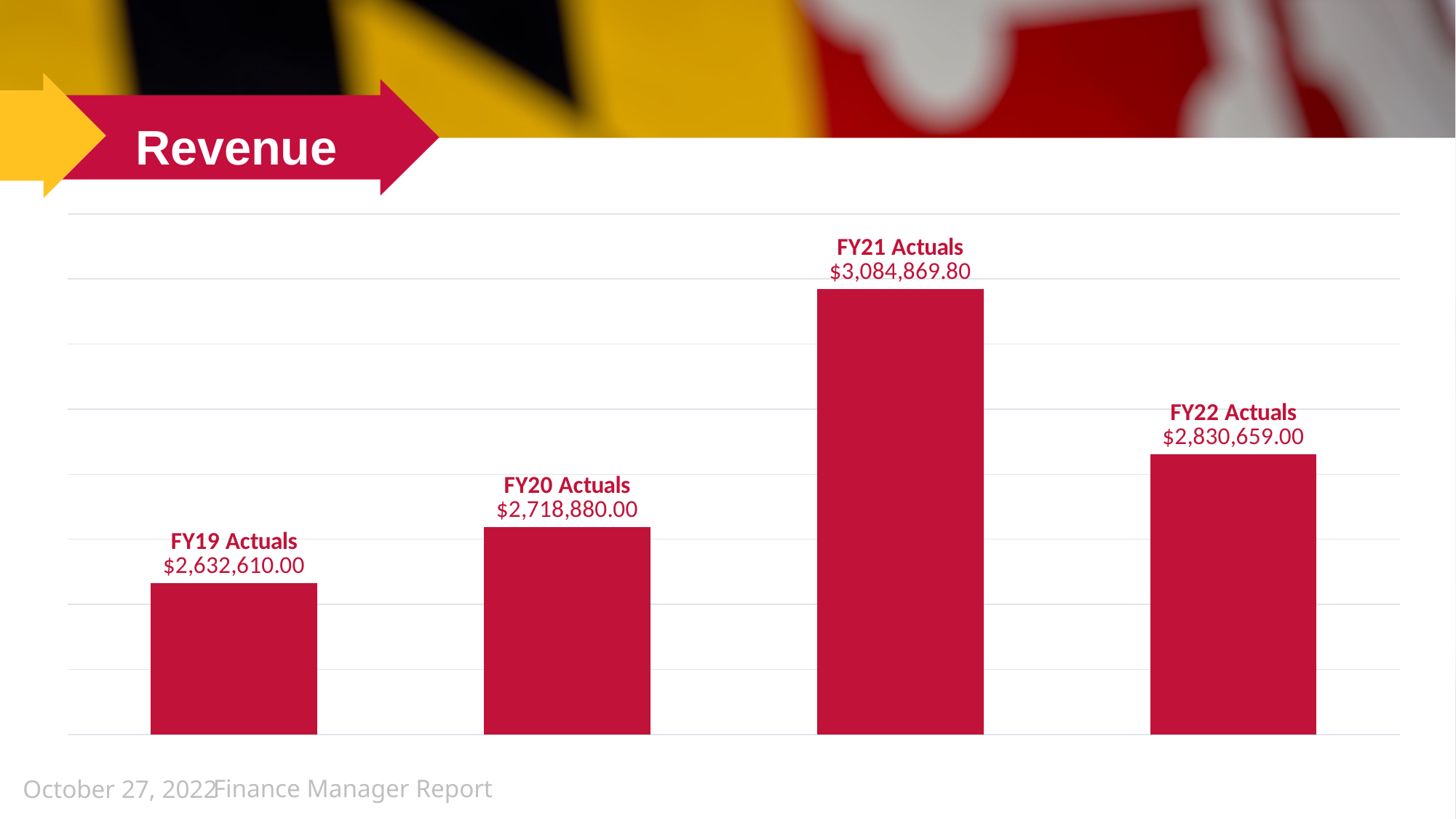
What is the value for FY22 Actuals? $2,830,659.00 What is the value for FY21 Actuals? $3,084,869.80 What kind of chart is shown on the slide? Bar chart What is the difference between FY21 Actuals and FY19 Actuals? $452,259.80 Which fiscal year has the lowest revenue? FY19 Actuals What is the value for FY20 Actuals? $2,718,880.00 What is the value for FY19 Actuals? $2,632,610.00 How many bars are shown in the chart? 4 What is the difference between FY22 Actuals and FY20 Actuals? $111,779.00 Which is larger, FY22 Actuals or FY20 Actuals? FY22 Actuals Which fiscal year has the highest revenue? FY21 Actuals Does revenue rise or fall from FY21 Actuals to FY22 Actuals? Fall